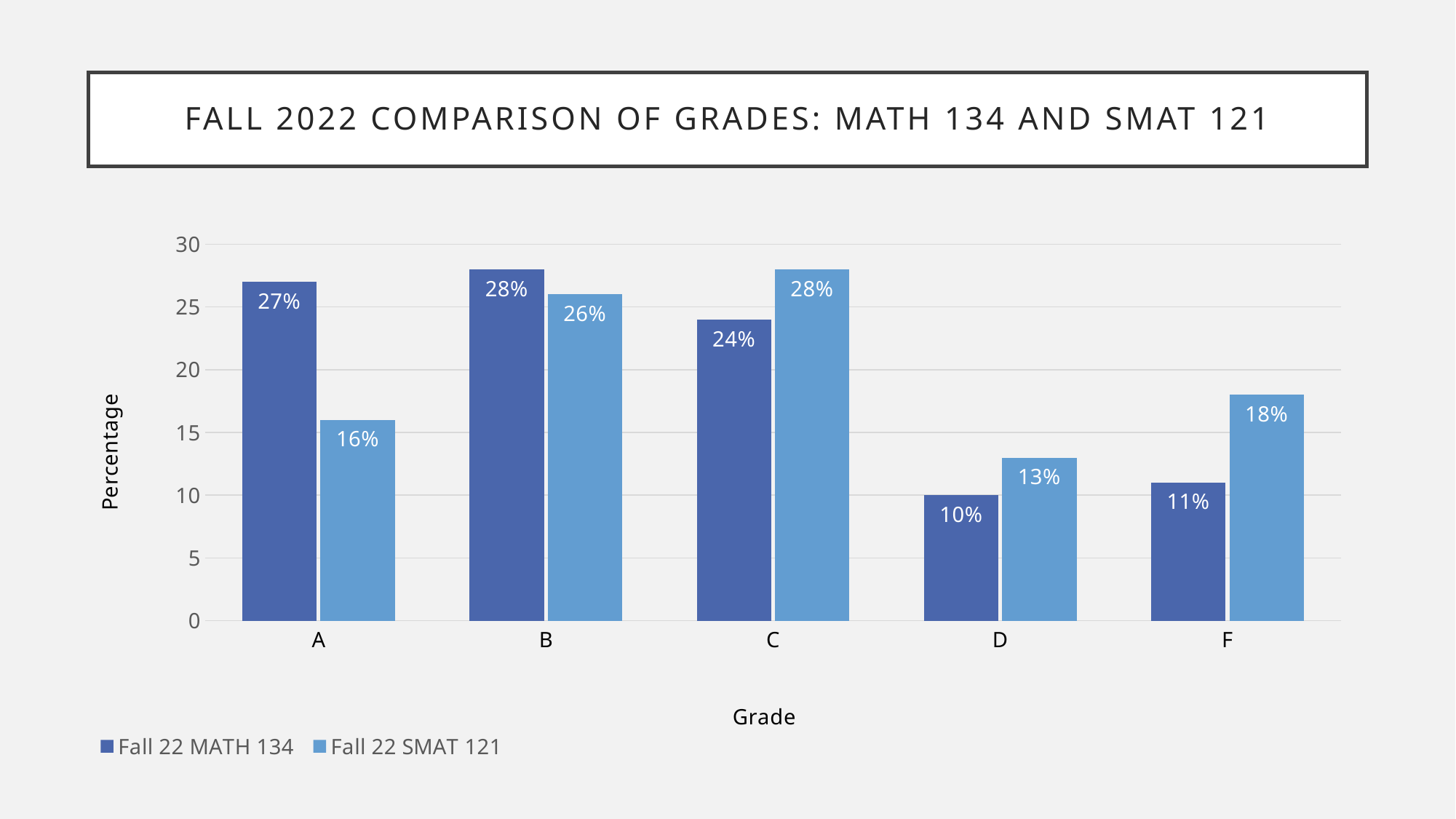
How many series does the legend list? 2 Which grade has the lowest percentage for Fall 22 SMAT 121? D What kind of chart is shown on the slide? Bar chart How many grade categories are shown on the x axis? 5 What percentage of Fall 22 SMAT 121 students received a grade of F? 18% What is the difference between the Fall 22 MATH 134 and Fall 22 SMAT 121 percentages for grade A? 11% What is the label of the y axis? Percentage For grade C, which series has the larger percentage, Fall 22 MATH 134 or Fall 22 SMAT 121? Fall 22 SMAT 121 Is the Fall 22 MATH 134 value for grade D greater or less than 15? less What is the value for grade D in the Fall 22 SMAT 121 series? 13% Which grade has the highest percentage for Fall 22 MATH 134? B What percentage of Fall 22 MATH 134 students received a grade of A? 27%